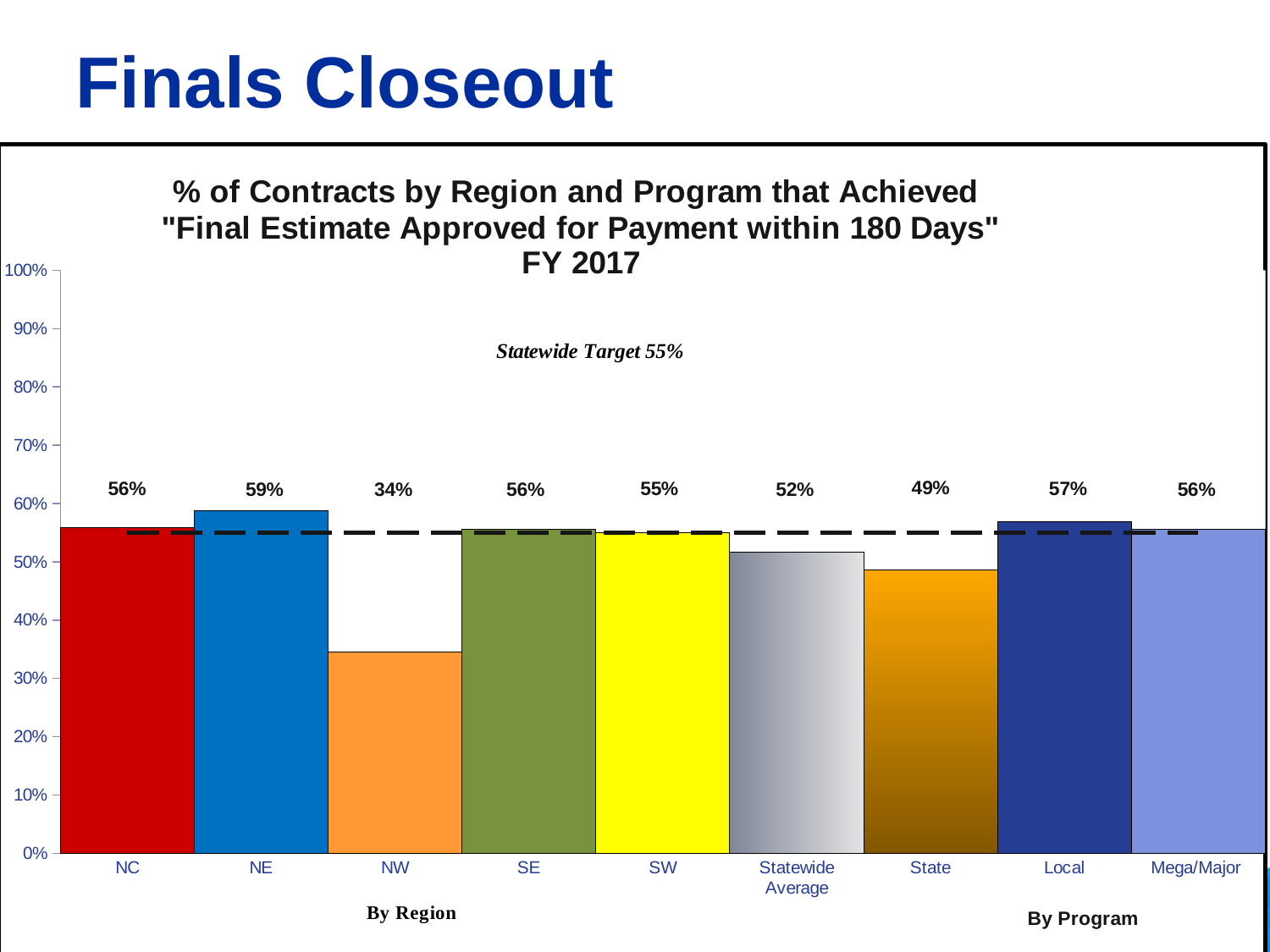
What kind of chart is shown on the slide? bar chart Is the value for NW greater or less than 40%? less Which is larger, the value for State or the value for Mega/Major? Mega/Major Which category has the lowest value? NW What is the value for the Statewide Average? 52% What fiscal year does the chart title refer to? FY 2017 What is the difference between the values for NE and NW? 25% What is the value for NW? 34% What is the value for Local? 57% Which category has the highest value? NE How many bars are shown in the chart? 9 What is the Statewide Target shown on the chart? 55%